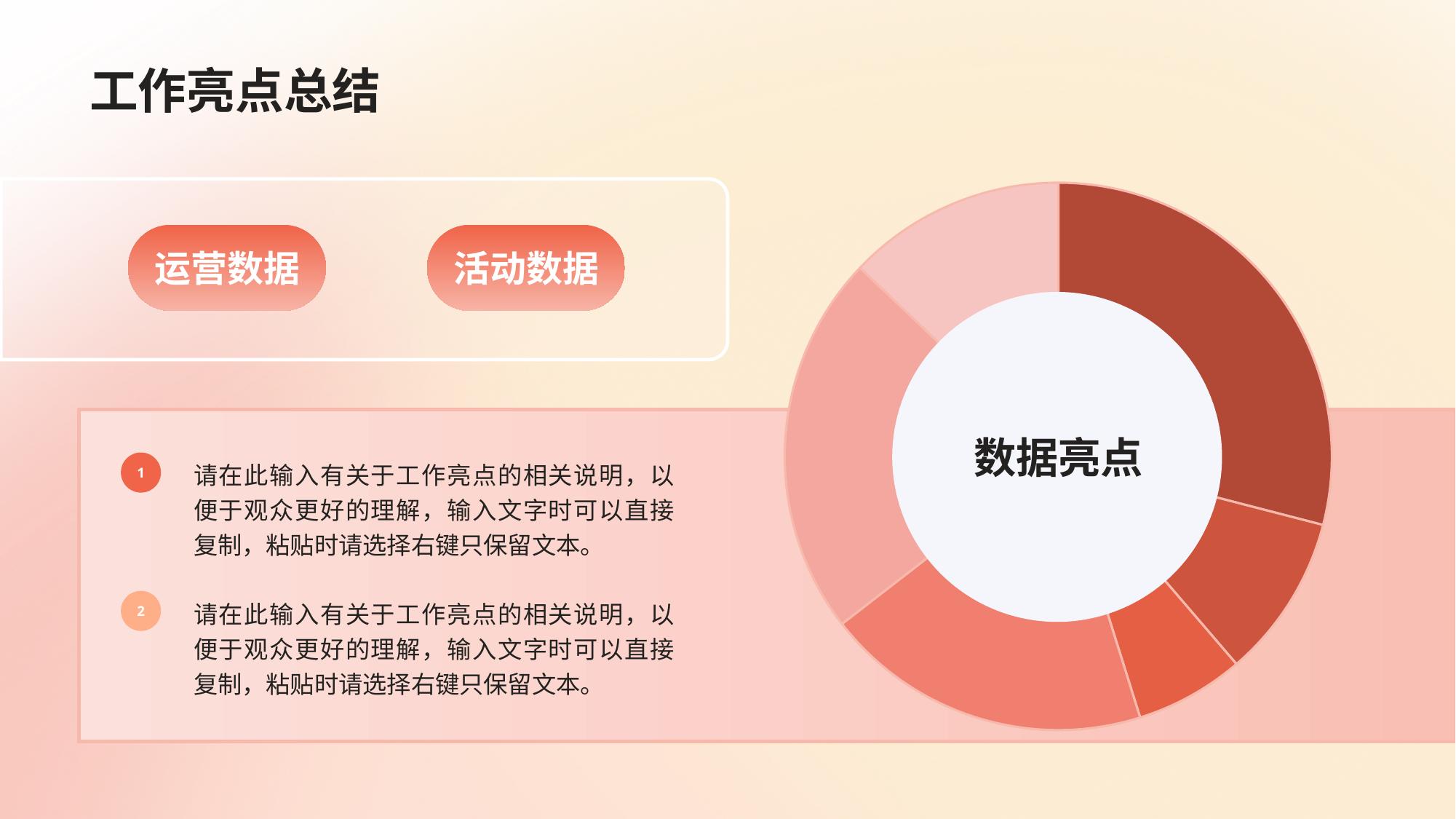
Does the doughnut chart display a legend? No What text is written in the centre of the doughnut chart? 数据亮点 How many slices does the doughnut chart have? 6 What kind of chart is shown on the slide? doughnut chart Which slice of the doughnut chart is the largest, by colour? the dark red slice